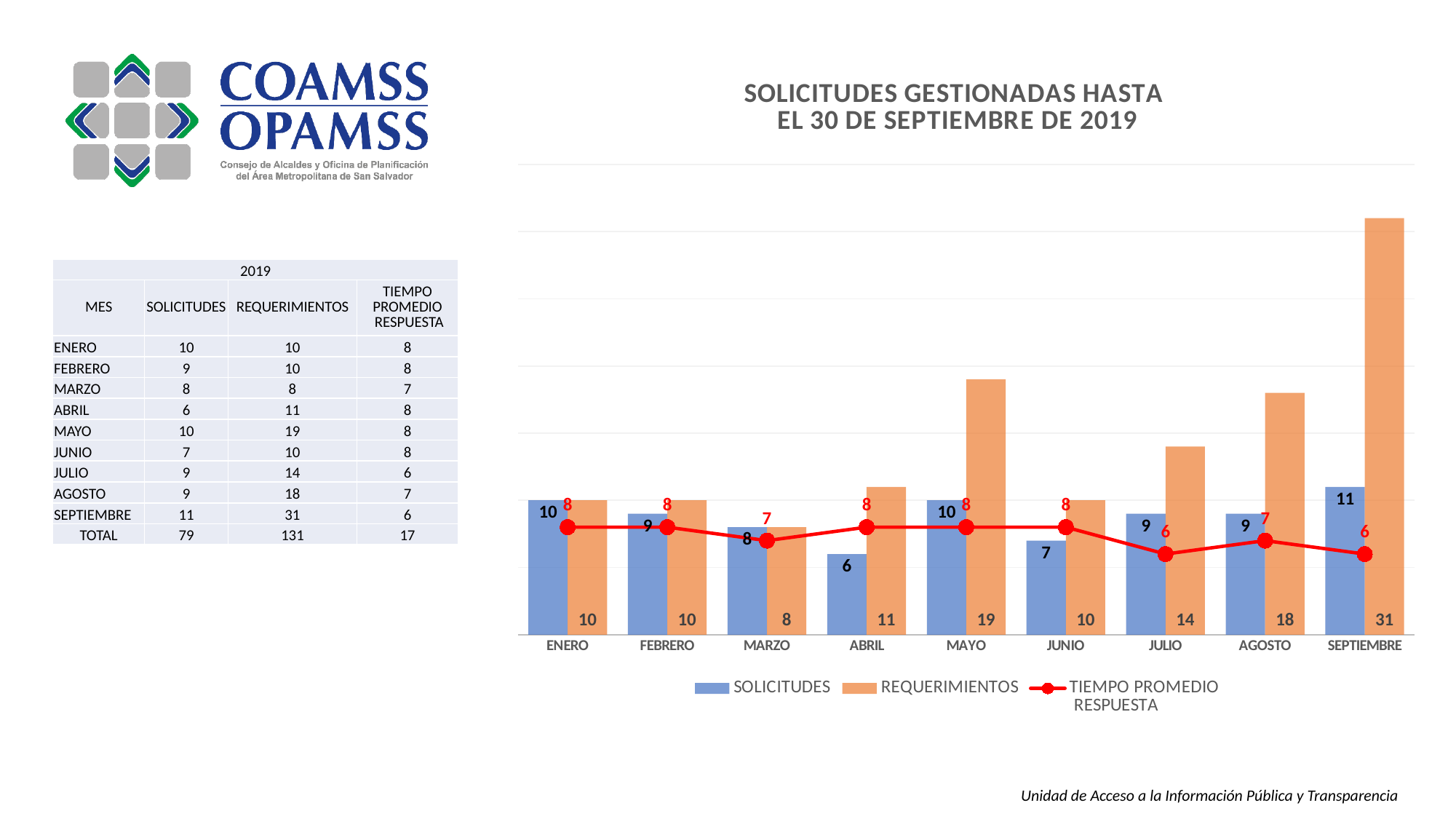
What is the difference between REQUERIMIENTOS and SOLICITUDES in MAYO? 9 What is the value of REQUERIMIENTOS for SEPTIEMBRE? 31 Does the TIEMPO PROMEDIO RESPUESTA line rise or fall from JUNIO to JULIO? Fall Which month has the highest REQUERIMIENTOS value? SEPTIEMBRE What is the title of the chart? SOLICITUDES GESTIONADAS HASTA EL 30 DE SEPTIEMBRE DE 2019 How many months are shown on the x axis of the chart? 9 Which is larger in AGOSTO, SOLICITUDES or REQUERIMIENTOS? REQUERIMIENTOS What is the value of SOLICITUDES for ABRIL? 6 How many series does the chart legend list? 3 What is the TIEMPO PROMEDIO RESPUESTA value for JULIO? 6 What kind of chart is shown on the slide? Combined bar and line chart Which month has the lowest SOLICITUDES value? ABRIL